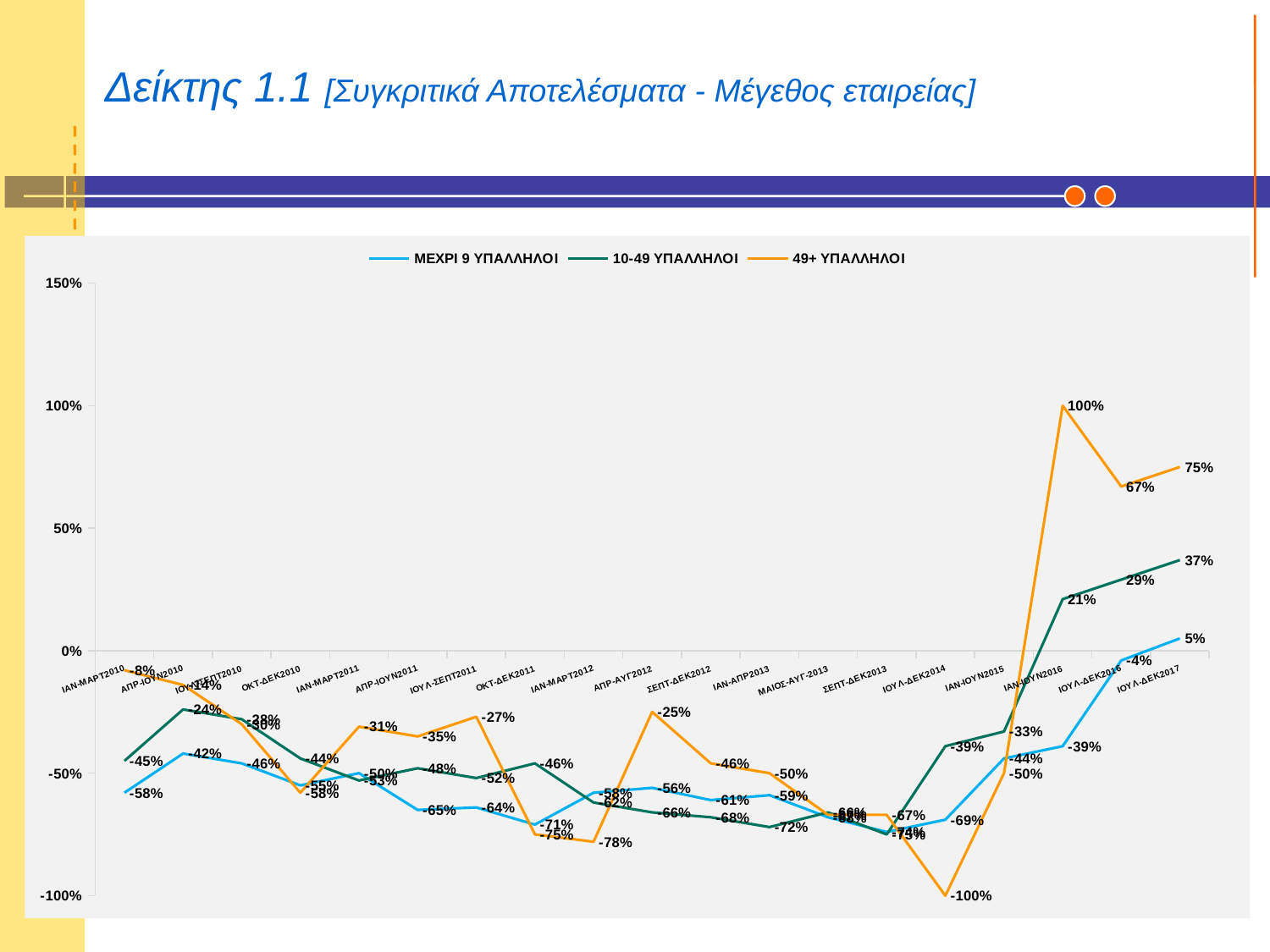
In ΙΟΥΛ-ΔΕΚ2016, which series has the higher value: ΜΕΧΡΙ 9 ΥΠΑΛΛΗΛΟΙ or 10-49 ΥΠΑΛΛΗΛΟΙ? 10-49 ΥΠΑΛΛΗΛΟΙ What type of chart is shown on the slide? Line chart What are the three series named in the legend? ΜΕΧΡΙ 9 ΥΠΑΛΛΗΛΟΙ, 10-49 ΥΠΑΛΛΗΛΟΙ, 49+ ΥΠΑΛΛΗΛΟΙ Does the 10-49 ΥΠΑΛΛΗΛΟΙ series rise or fall from ΙΑΝ-ΙΟΥΝ2016 to ΙΟΥΛ-ΔΕΚ2017? Rise In which period does 49+ ΥΠΑΛΛΗΛΟΙ reach its highest value, and what is it? ΙΑΝ-ΙΟΥΝ2016, 100% What is the value for 10-49 ΥΠΑΛΛΗΛΟΙ in ΙΟΥΛ-ΔΕΚ2016? 29% What is the difference between 49+ ΥΠΑΛΛΗΛΟΙ and 10-49 ΥΠΑΛΛΗΛΟΙ in ΙΟΥΛ-ΔΕΚ2017? 38 percentage points What is the lowest value for 49+ ΥΠΑΛΛΗΛΟΙ, and in which period? -100%, ΙΟΥΛ-ΔΕΚ2014 What is the value for ΜΕΧΡΙ 9 ΥΠΑΛΛΗΛΟΙ in ΙΑΝ-ΜΑΡΤ2010? -58% How many periods are shown along the x axis? 19 How many series does the legend list? 3 What is the value for 49+ ΥΠΑΛΛΗΛΟΙ in ΙΟΥΛ-ΔΕΚ2017? 75%